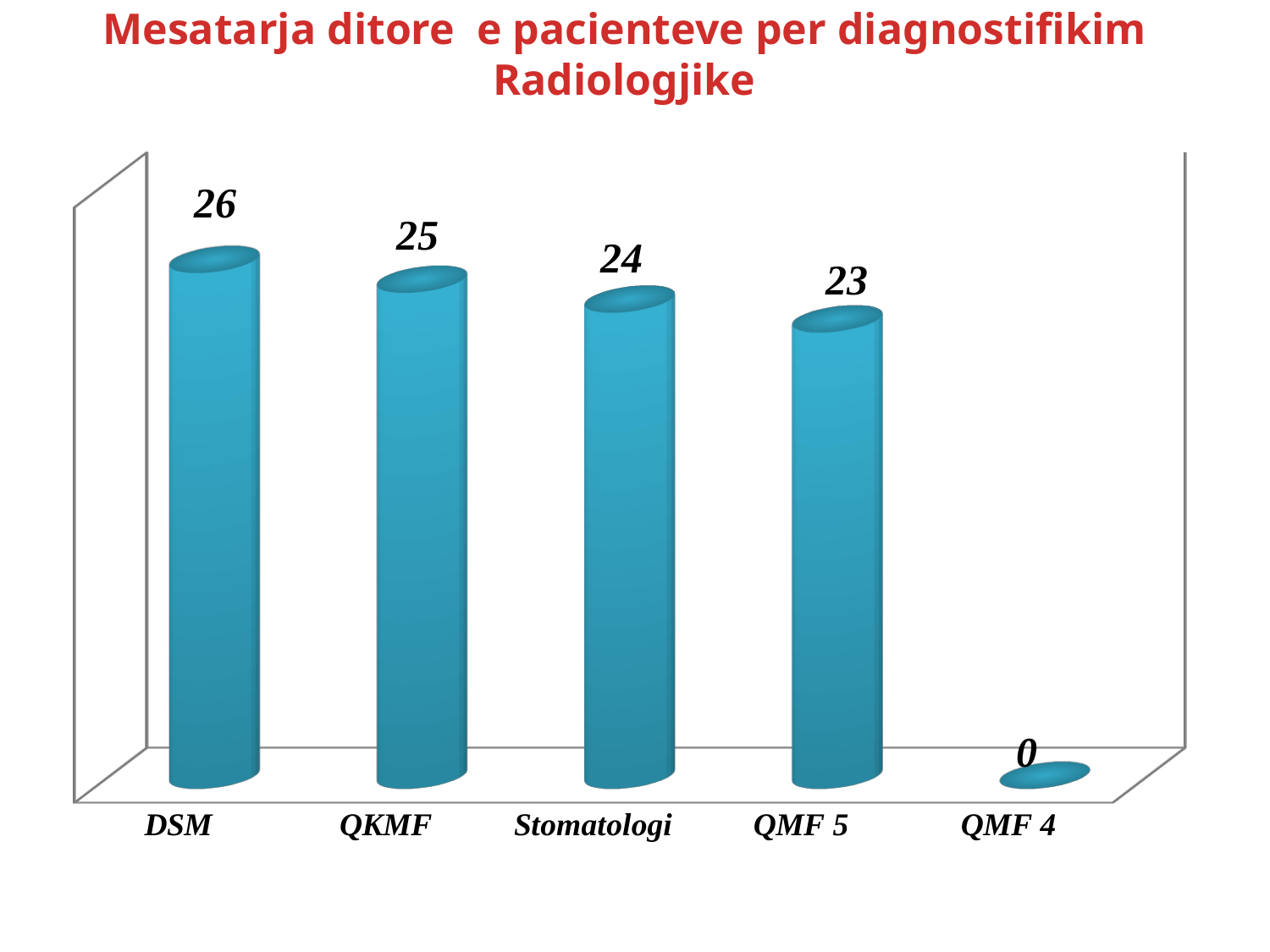
What kind of chart is shown on the slide? Bar chart What is the difference between the values for DSM and QMF 5? 3 Do the values rise or fall from left to right along the x axis? Fall What is the value for Stomatologi? 24 How many categories are shown on the x axis? 5 What is the value for QMF 4? 0 Which category has the lowest value? QMF 4 What is the value for QKMF? 25 What is the value for QMF 5? 23 What is the value for DSM? 26 Which category has the highest value? DSM Which is larger, the value for QKMF or the value for Stomatologi? QKMF